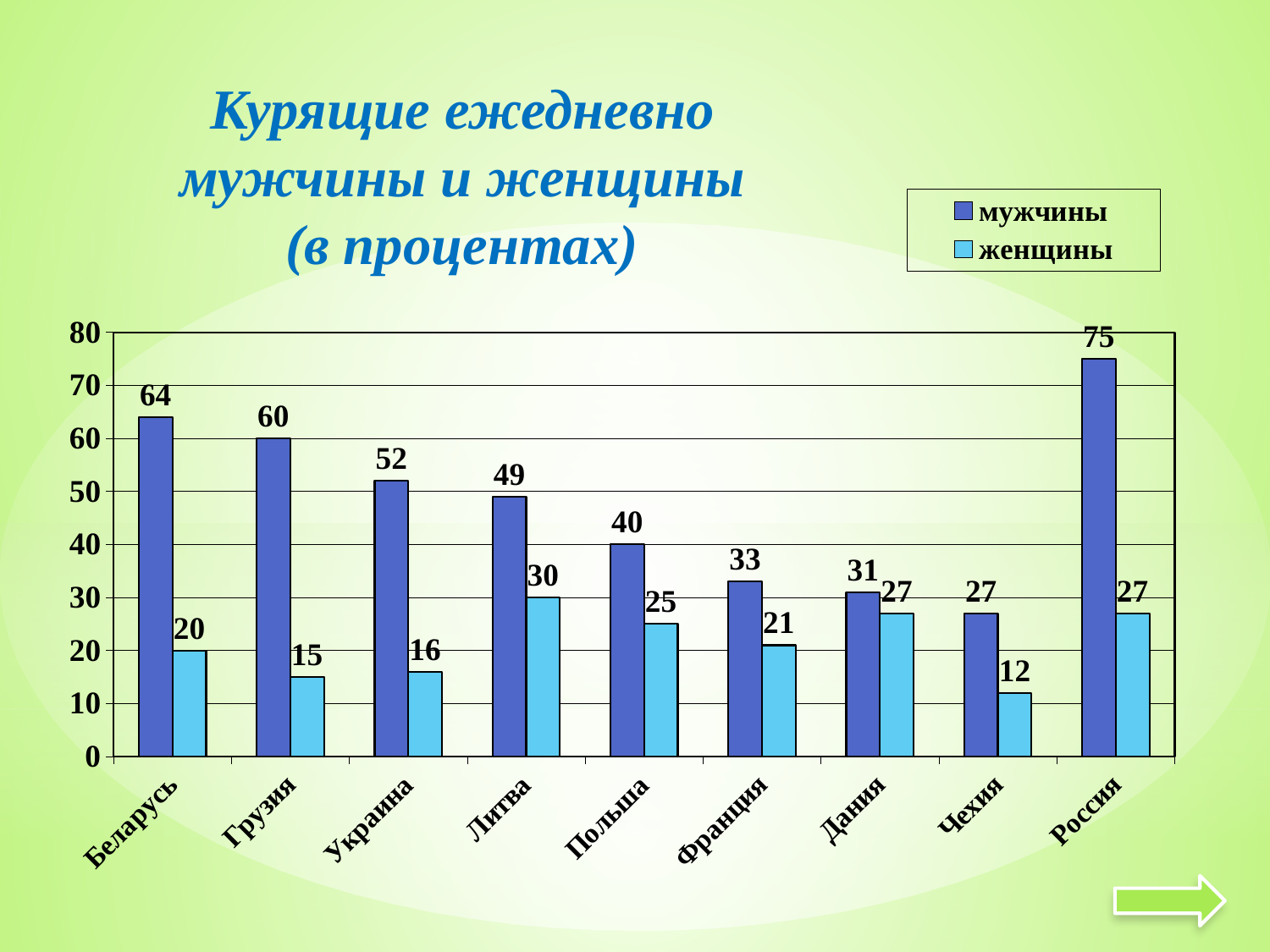
How many series does the legend list? 2 What is the title of the chart? Курящие ежедневно мужчины и женщины (в процентах) Which country has the lowest value for женщины? Чехия Which country has the highest value for мужчины? Россия How many countries are shown on the x axis? 9 What is the difference between the мужчины and женщины values for Беларусь? 44 Is the value for мужчины in Украина greater or less than 50? greater Which country has the lowest value for мужчины? Чехия What kind of chart is shown on the slide? bar chart Which is larger: the женщины value for Польша or the женщины value for Франция? Польша What is the value for мужчины in Россия? 75 What is the value for женщины in Литва? 30